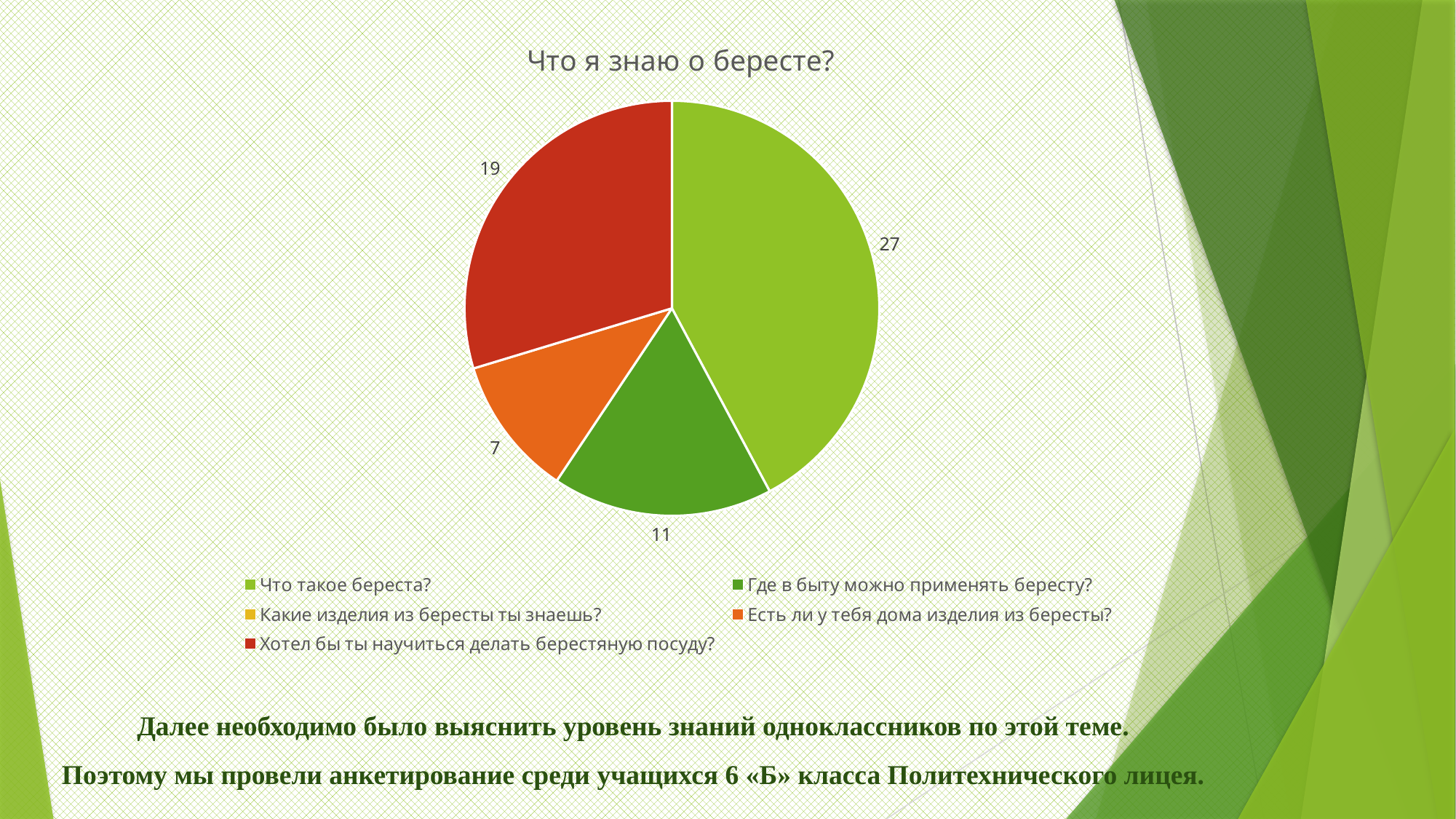
What is the value for "Где в быту можно применять бересту?"? 11 Which labelled slice has the smallest value? Есть ли у тебя дома изделия из бересты? How many slices with data labels are shown in the pie? 4 What is the title of the chart? Что я знаю о бересте? What is the value for "Хотел бы ты научиться делать берестяную посуду?"? 19 What is the value for "Что такое береста?"? 27 Which is larger: the value for "Где в быту можно применять бересту?" or the value for "Есть ли у тебя дома изделия из бересты?"? Где в быту можно применять бересту? What is the value for "Есть ли у тебя дома изделия из бересты?"? 7 Which category has the largest slice of the pie? Что такое береста? What is the difference between the values for "Что такое береста?" and "Хотел бы ты научиться делать берестяную посуду?"? 8 What kind of chart is shown on the slide? pie chart How many entries does the legend list? 5